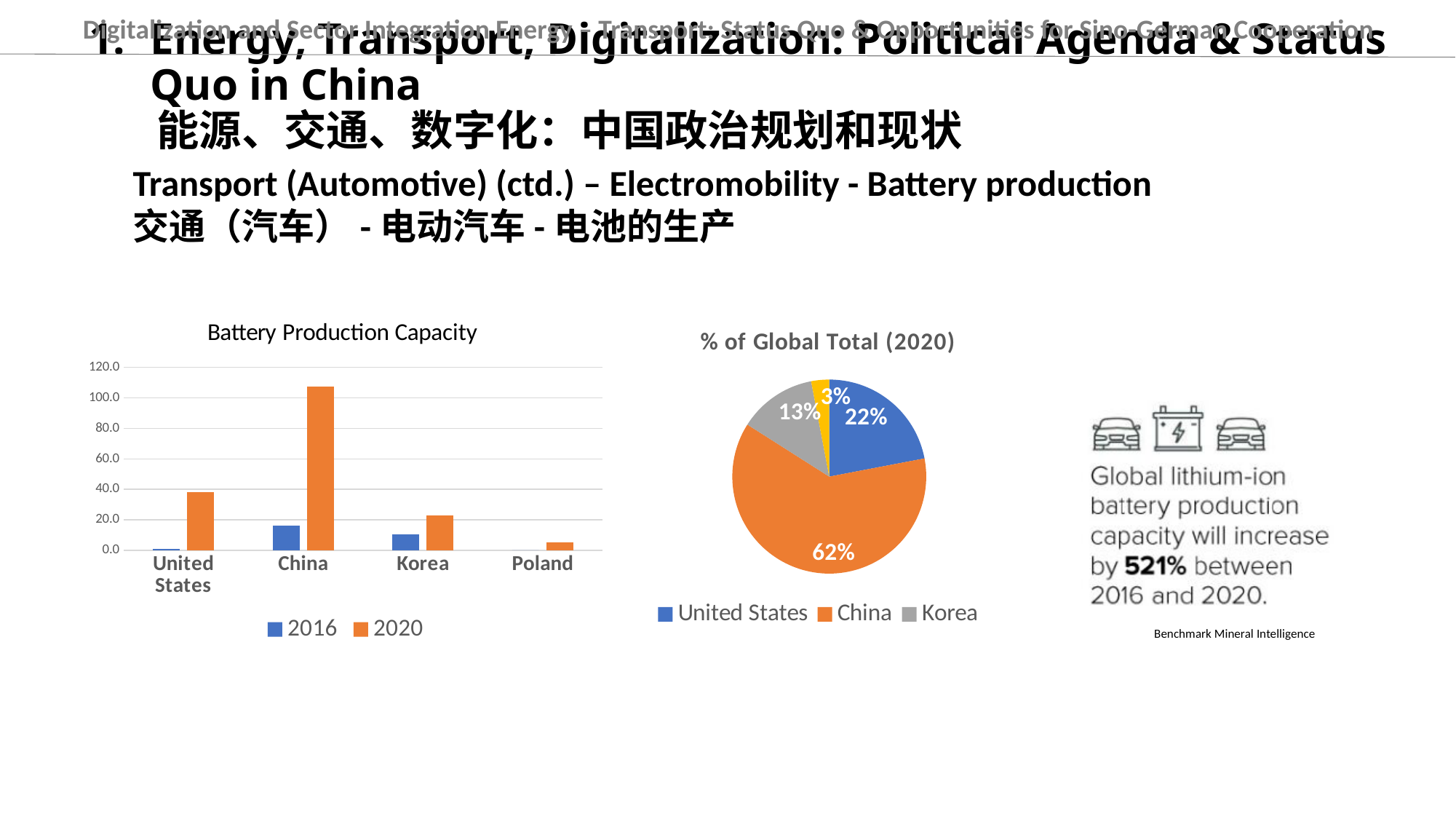
What type of chart is the '% of Global Total (2020)' chart? pie chart In the 'Battery Production Capacity' chart, is the 2016 value for China greater or less than 20? less What type of chart is the 'Battery Production Capacity' chart? bar chart In the 'Battery Production Capacity' chart, which country has the highest 2020 value? China In the 'Battery Production Capacity' chart, how many countries are shown on the x axis? 4 In the '% of Global Total (2020)' pie chart, what share does China have? 62% In the 'Battery Production Capacity' chart, how many series does the legend list? 2 In the 'Battery Production Capacity' chart, which is larger for Korea: the 2016 value or the 2020 value? 2020 In the 'Battery Production Capacity' chart, is the 2020 value for China greater or less than 100? greater In the '% of Global Total (2020)' pie chart, what is the difference between China's share and the United States' share? 40% In the '% of Global Total (2020)' pie chart, how many entries does the legend list? 3